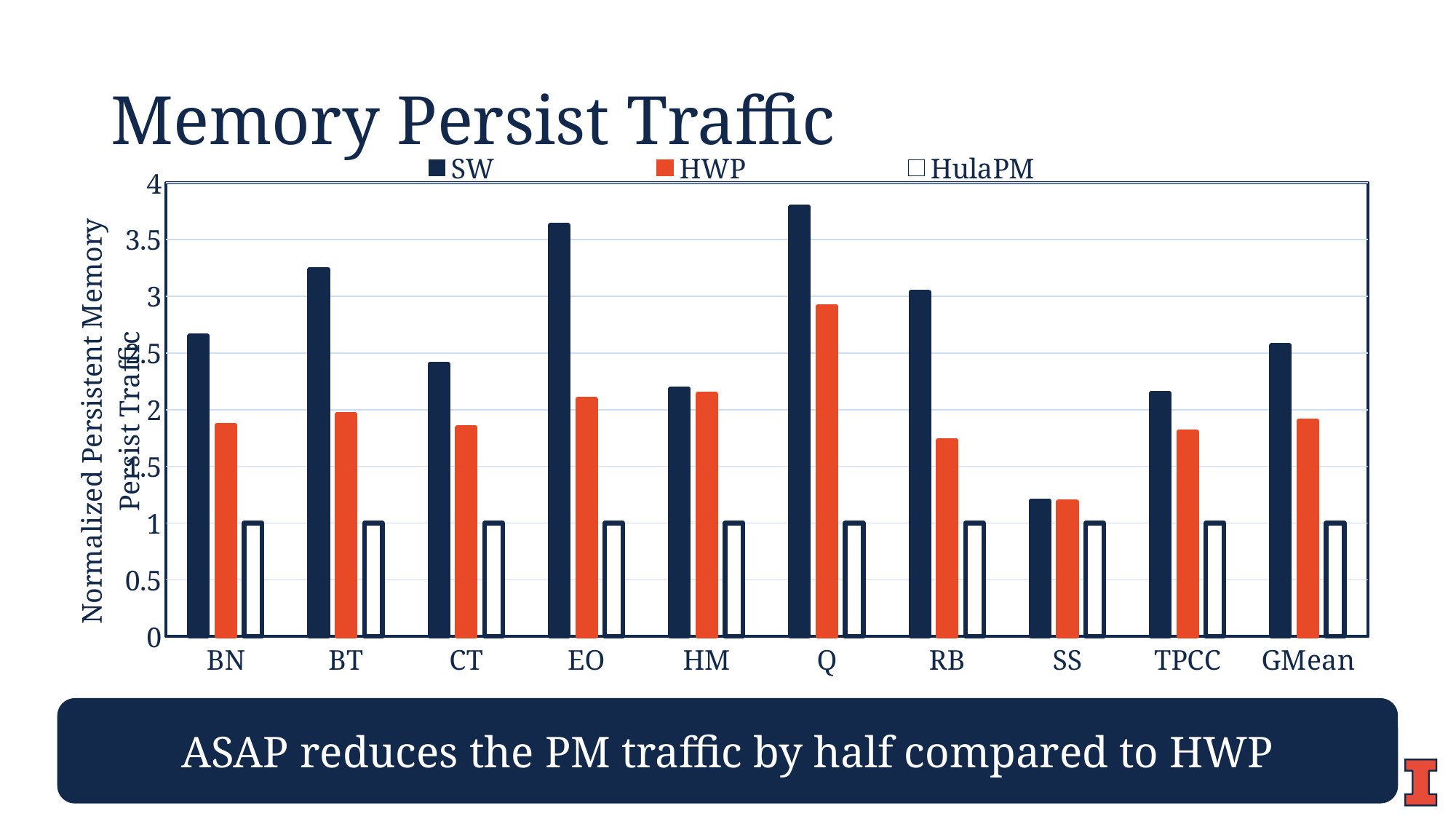
For BT, which is larger, the SW value or the HWP value? SW Is the SW value for Q greater or less than 3.5? greater Which category has the highest HWP value? Q Which category has the lowest SW value? SS Is the HWP value for RB greater or less than 2? less Is the SW value for BT greater or less than 3? greater How many categories are shown on the x axis? 10 How many series does the legend list? 3 What is the title of the slide? Memory Persist Traffic What is the HulaPM value for BN? 1 What kind of chart is shown on the slide? bar chart What are the three series named in the legend? SW, HWP, HulaPM